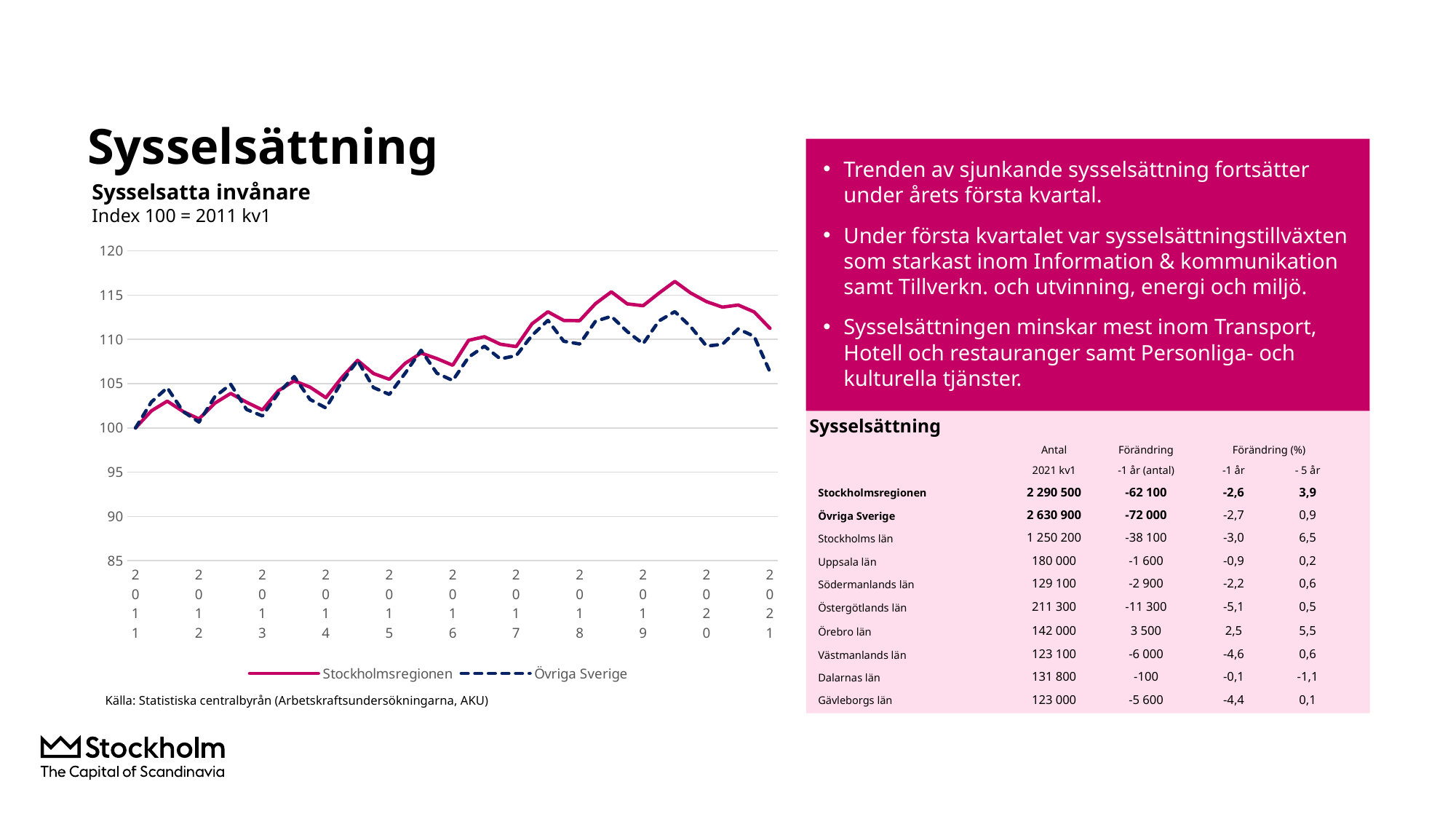
In the 'Sysselsatta invånare' chart, is the final 2021 value for Stockholmsregionen greater or less than 110? greater What is the index value for both series at the start of the 'Sysselsatta invånare' chart (2011 kv1)? 100 In the 'Sysselsatta invånare' chart, is the peak value of Stockholmsregionen greater or less than 115? greater In the 'Sysselsatta invånare' chart, does the Övriga Sverige index rise or fall from 2020 to 2021? fall In the 'Sysselsatta invånare' chart, is the final 2021 value for Övriga Sverige greater or less than 110? less In the 'Sysselsatta invånare' chart, which series reaches the highest index value over the whole period? Stockholmsregionen In the 'Sysselsatta invånare' chart, which series is higher at the end of the period in 2021? Stockholmsregionen Which two series are shown in the legend of the 'Sysselsatta invånare' chart? Stockholmsregionen and Övriga Sverige In the 'Sysselsatta invånare' chart, does the Stockholmsregionen index generally rise or fall from 2011 to 2019? rise How many year labels are shown on the x axis of the 'Sysselsatta invånare' chart? 11 What kind of chart is shown under the heading 'Sysselsatta invånare'? line chart How many series does the legend of the 'Sysselsatta invånare' chart list? 2